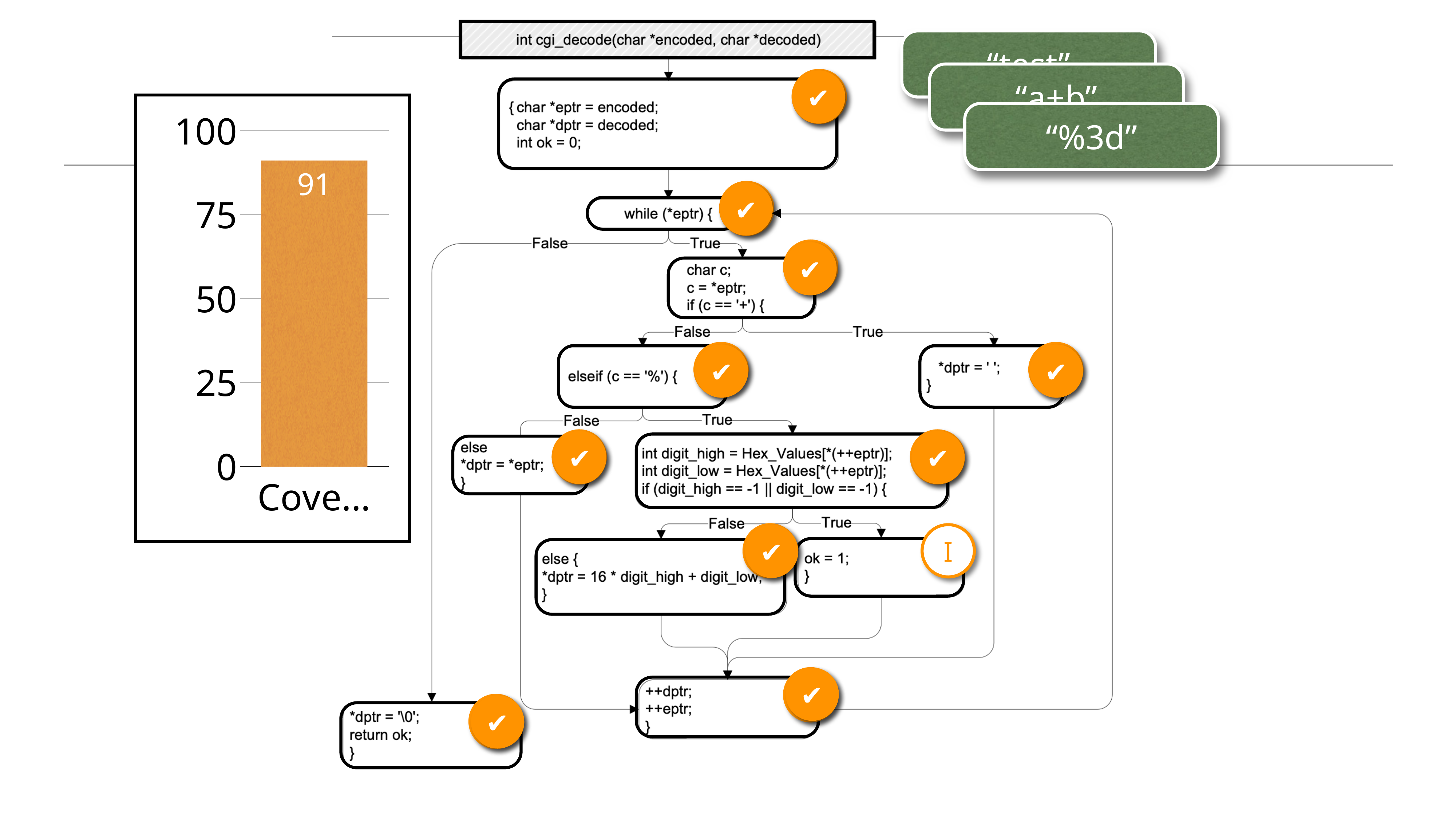
Is the value of the bar greater or less than 50? greater What is the highest tick value shown on the chart's vertical axis? 100 What colour is the bar in the chart? orange Is the value of the bar greater or less than 100? less What value is shown on the bar in the bar chart? 91 What kind of chart is shown on the left of the slide? bar chart Is the value of the bar greater or less than 75? greater How many bars does the chart contain? 1